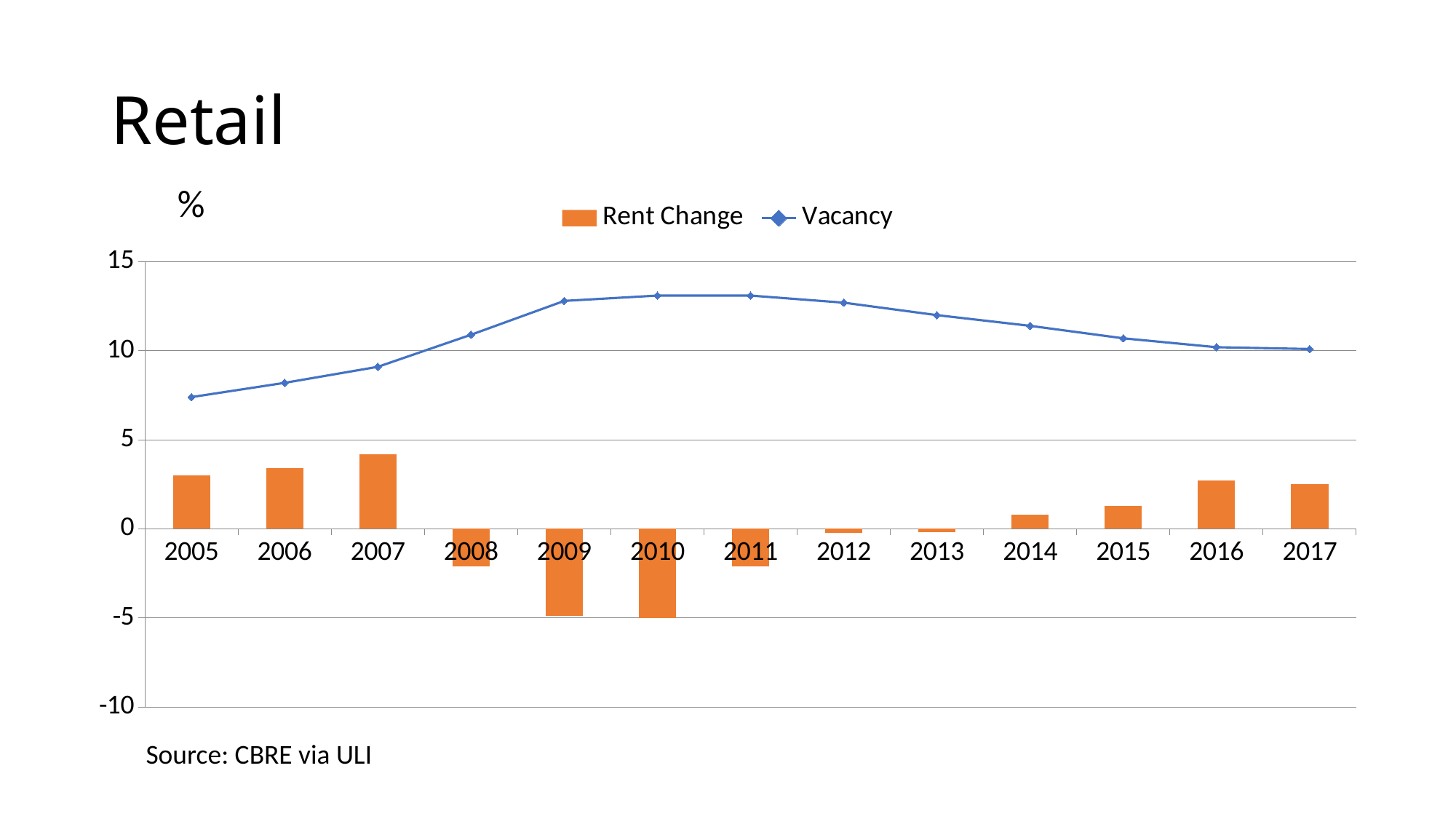
Which is larger, the Vacancy value for 2005 or for 2009? 2009 Does the Vacancy line rise or fall from 2005 to 2010? rise How many series does the legend list? 2 How many years are shown on the x axis? 13 Is the Vacancy value for 2005 greater or less than 10? less Which is larger, the Rent Change value for 2014 or for 2016? 2016 Which series is shown as orange bars in the legend? Rent Change Which year has the lowest Vacancy value? 2005 Which year has the highest Rent Change value? 2007 What kind of chart is shown on the slide? A combined bar and line chart Is the Rent Change value for 2010 greater or less than 0? less Is the Vacancy value for 2013 greater or less than 10? greater